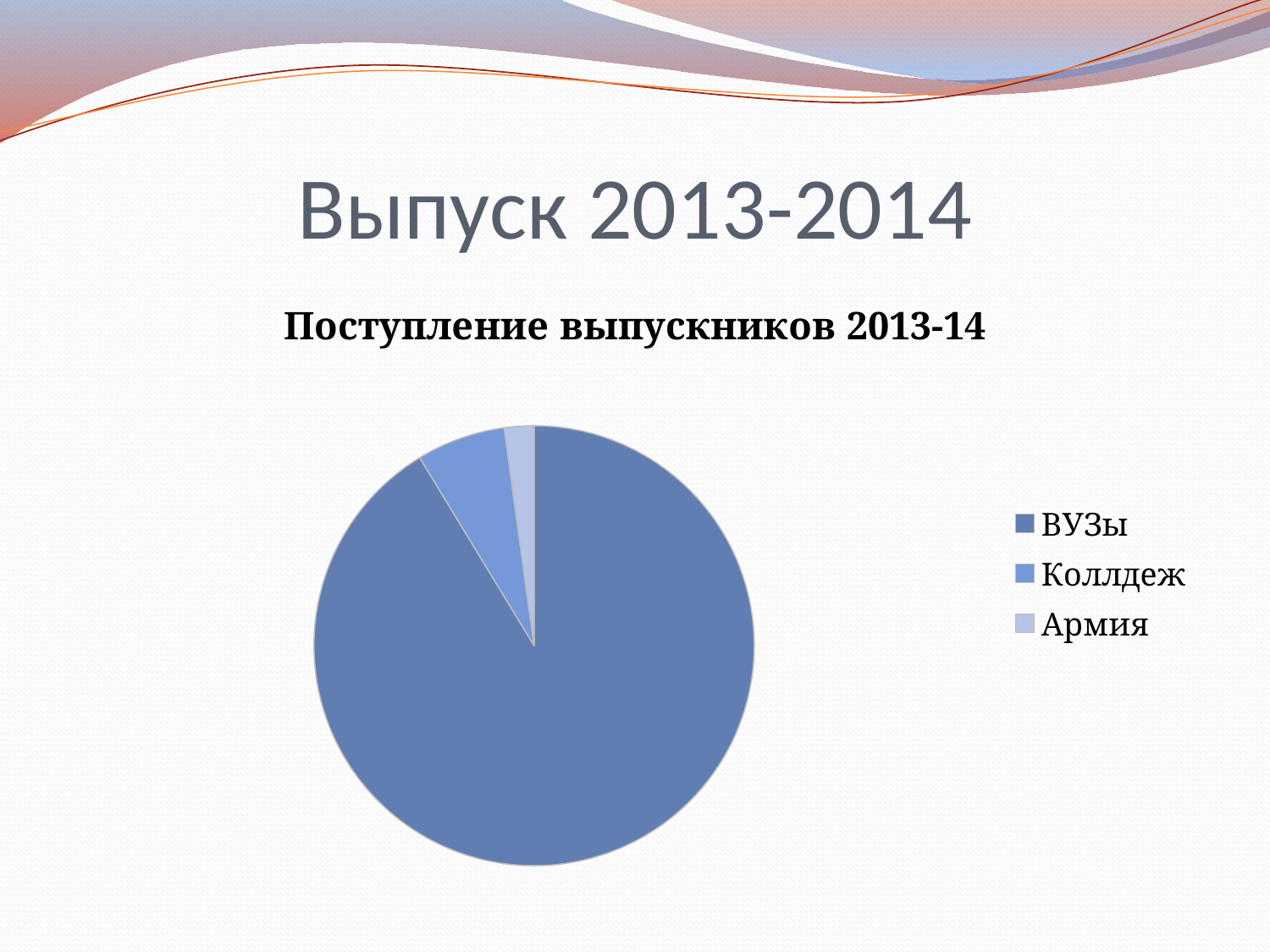
Which legend entry is listed first? ВУЗы Which slice is larger, Коллдеж or Армия? Коллдеж What kind of chart is shown on the slide? pie chart How many slices does the pie chart have? 3 Which slice is larger, ВУЗы or Коллдеж? ВУЗы How many entries does the legend list? 3 Which category has the largest slice of the pie? ВУЗы What is the title of the chart? Поступление выпускников 2013-14 Which category has the smallest slice of the pie? Армия